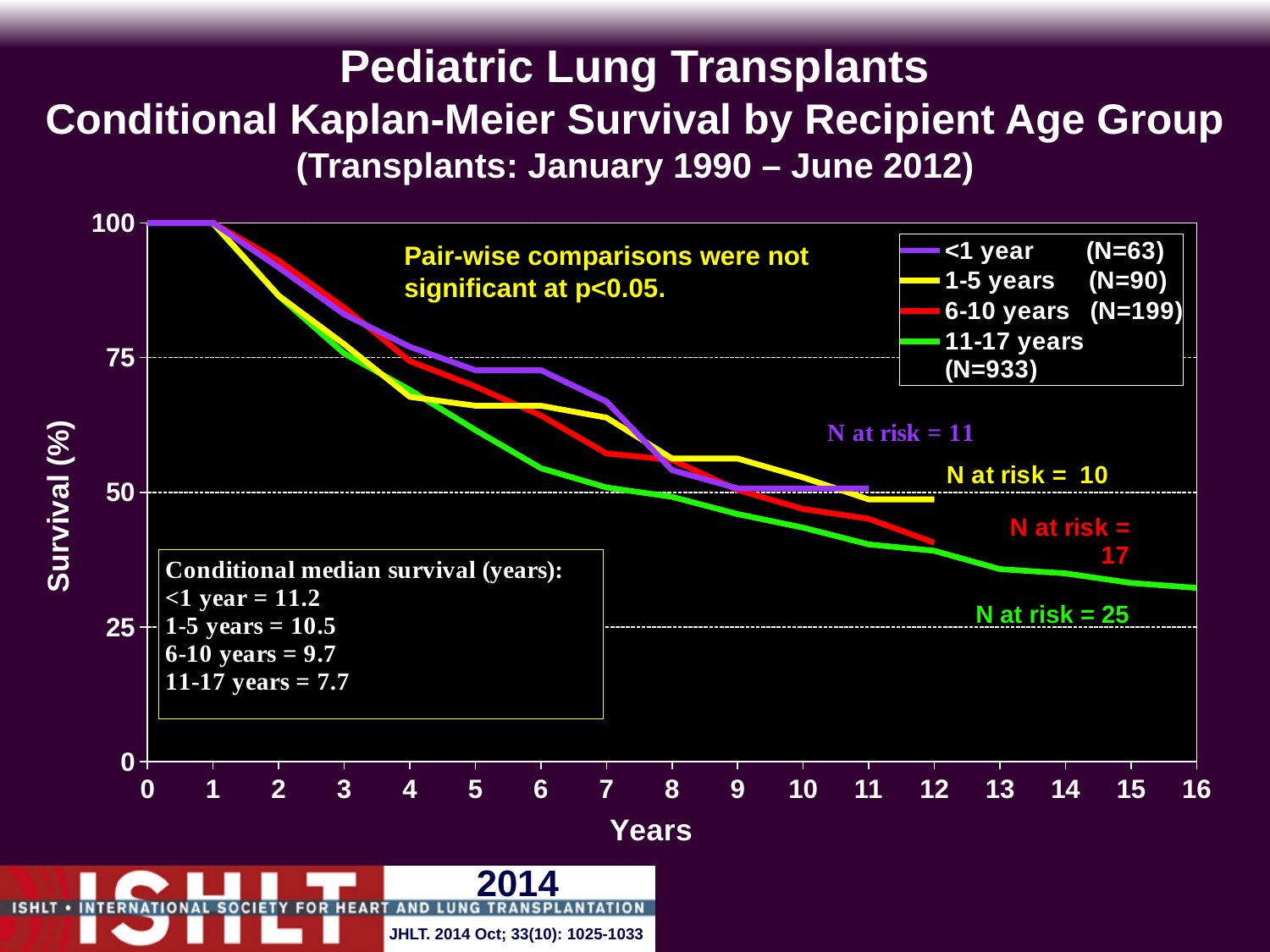
What kind of chart is shown on the slide? line chart What is the N for the 6-10 years group shown in the legend? N=199 How many series does the legend list? 4 Is the survival value for the 11-17 years group at 12 years greater or less than 50? less What is the conditional median survival in years for the <1 year group? 11.2 Do the survival curves rise or fall as years increase? fall Which recipient age group has the highest conditional median survival? <1 year Which group has a larger N at risk, 6-10 years or 11-17 years? 11-17 years What is the N at risk for the 11-17 years group? 25 Which recipient age group has the lowest conditional median survival? 11-17 years What is the difference in conditional median survival between the <1 year group and the 11-17 years group? 3.5 years What is the conditional median survival in years for the 11-17 years group? 7.7